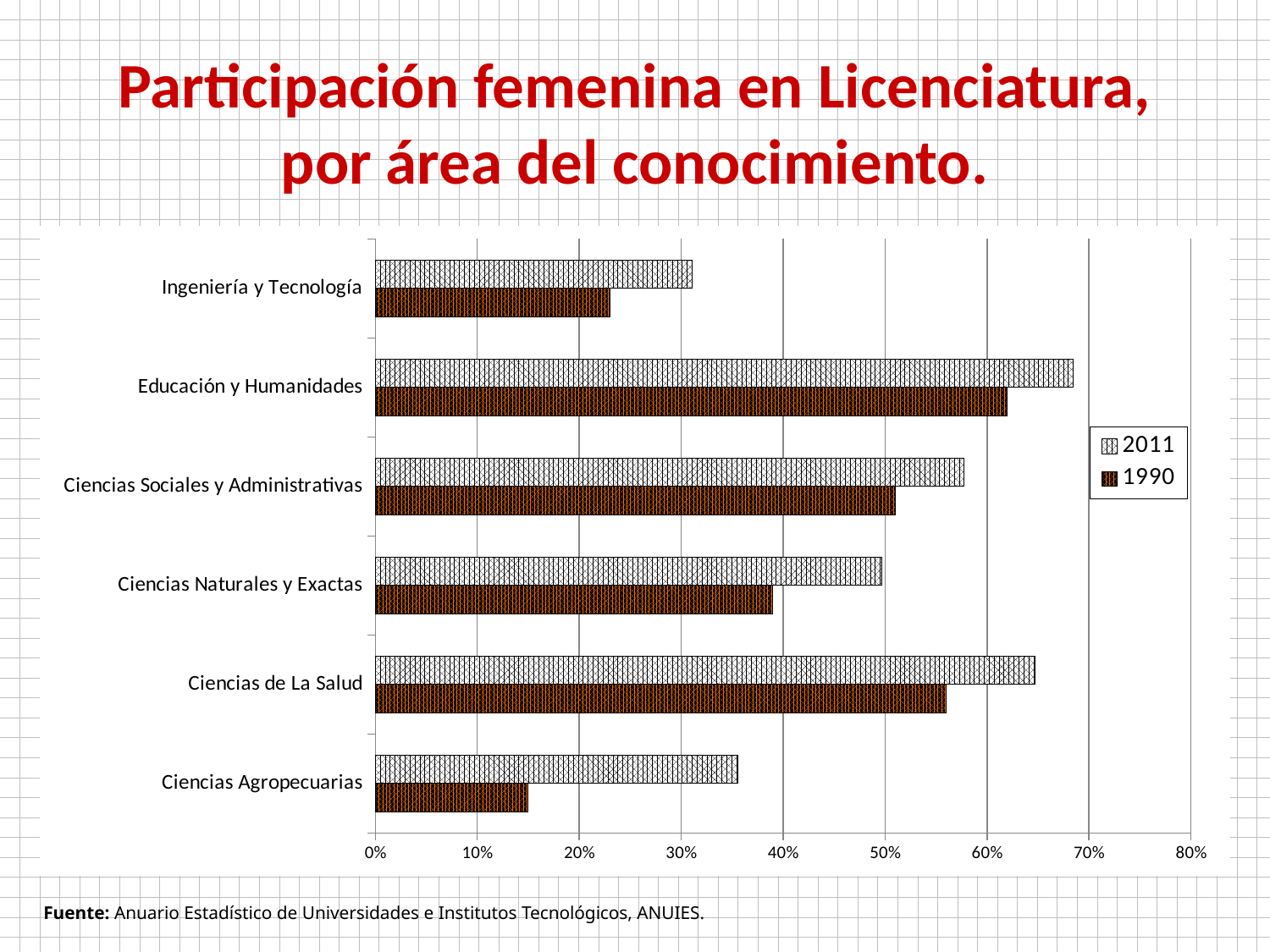
Is the 2011 value for Ciencias de La Salud greater or less than 60%? greater Which area has the highest value for 2011? Educación y Humanidades Is the 1990 value for Ingeniería y Tecnología greater or less than 30%? less Is the 1990 value for Ciencias Agropecuarias greater or less than 20%? less How many knowledge areas (categories) are shown on the chart? 6 How many series does the legend list? 2 Which area has the lowest value for 2011? Ingeniería y Tecnología Which area has the highest value for 1990? Educación y Humanidades What kind of chart is shown on the slide? bar chart Which series does the legend list first? 2011 For Ciencias Naturales y Exactas, which year has the larger value, 2011 or 1990? 2011 Which area has the lowest value for 1990? Ciencias Agropecuarias